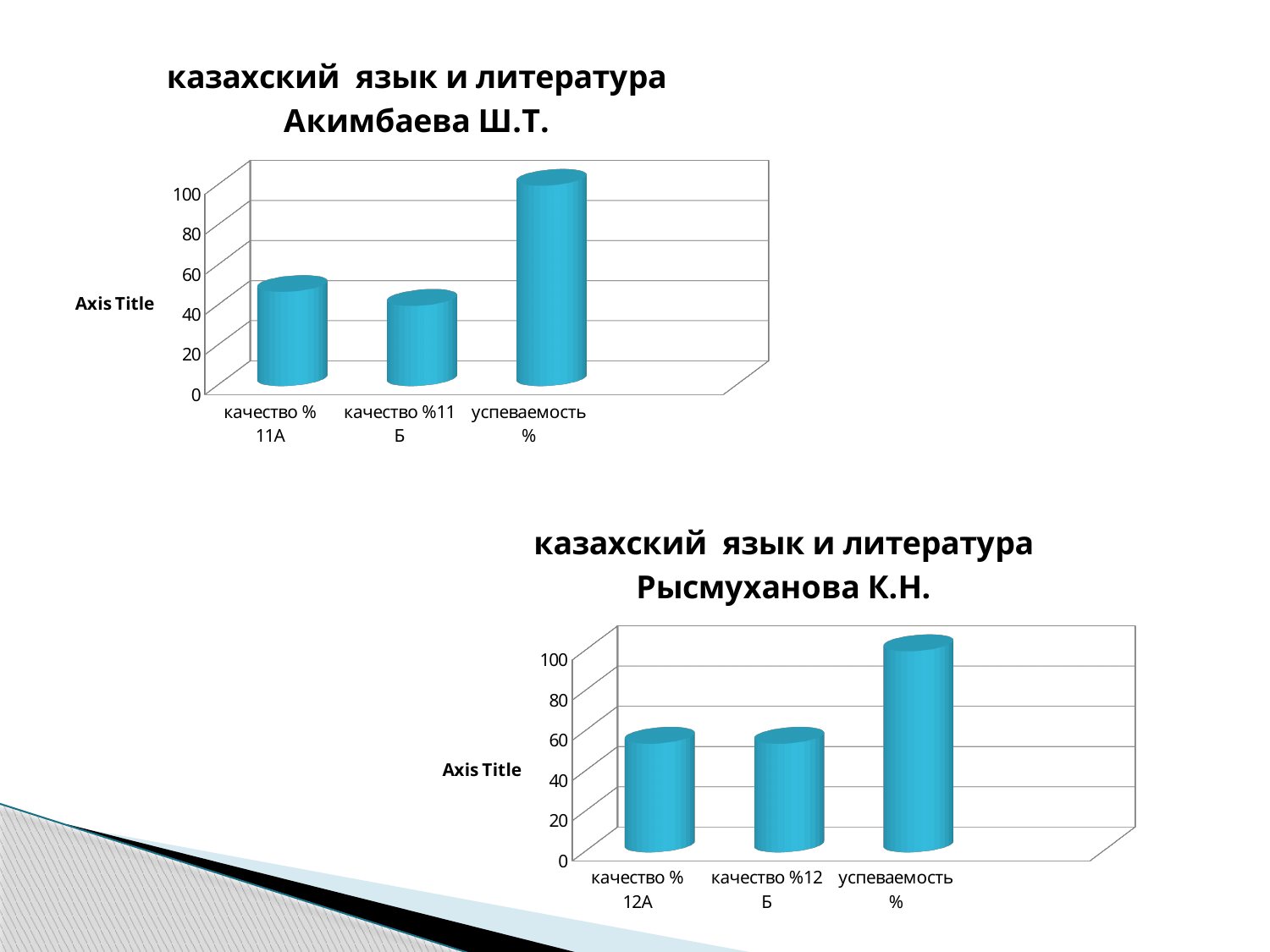
What kind of chart is the top chart (Акимбаева Ш.Т.)? bar chart How many categories are shown in the top chart (Акимбаева Ш.Т.)? 3 How many categories are shown in the bottom chart (Рысмуханова К.Н.)? 3 What is the title of the bottom chart? казахский язык и литература Рысмуханова К.Н. In the top chart (Акимбаева Ш.Т.), is the value for качество %11 Б greater or less than 60? less In the bottom chart (Рысмуханова К.Н.), which category has the highest value? успеваемость % In the top chart (Акимбаева Ш.Т.), which is larger: качество % 11А or качество %11 Б? качество % 11А In the top chart (Акимбаева Ш.Т.), which category has the lowest value? качество %11 Б In the top chart (Акимбаева Ш.Т.), is the value for успеваемость % greater or less than 80? greater In the bottom chart (Рысмуханова К.Н.), is the value for качество %12 Б greater or less than 80? less In the top chart (Акимбаева Ш.Т.), which category has the highest value? успеваемость %